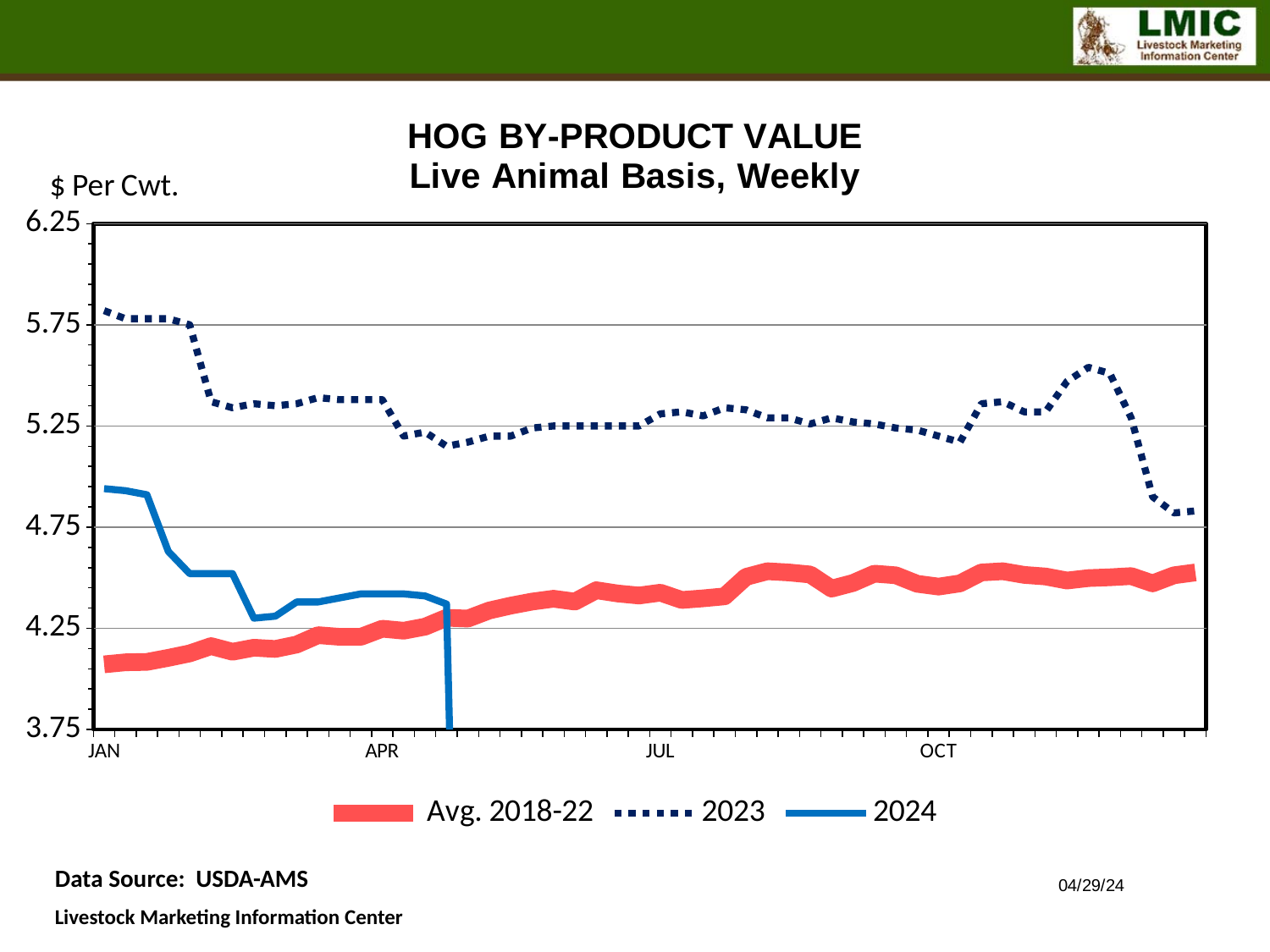
Is the value of the 2023 series at the end of the year (late December) greater or less than 5.25? less What kind of chart is shown on the slide? line chart Which series has the highest value in January? 2023 What unit is shown on the y axis of the chart? $ Per Cwt. Is the value of the 2024 series in January greater or less than 4.75? greater How many month labels are shown on the x axis? 4 In July, which is larger: the 2023 series or the Avg. 2018-22 series? 2023 What is the title of the chart? HOG BY-PRODUCT VALUE Live Animal Basis, Weekly Is the value of the 2023 series in January greater or less than 5.25? greater Does the 2024 series rise or fall from January to April? fall How many series does the legend list? 3